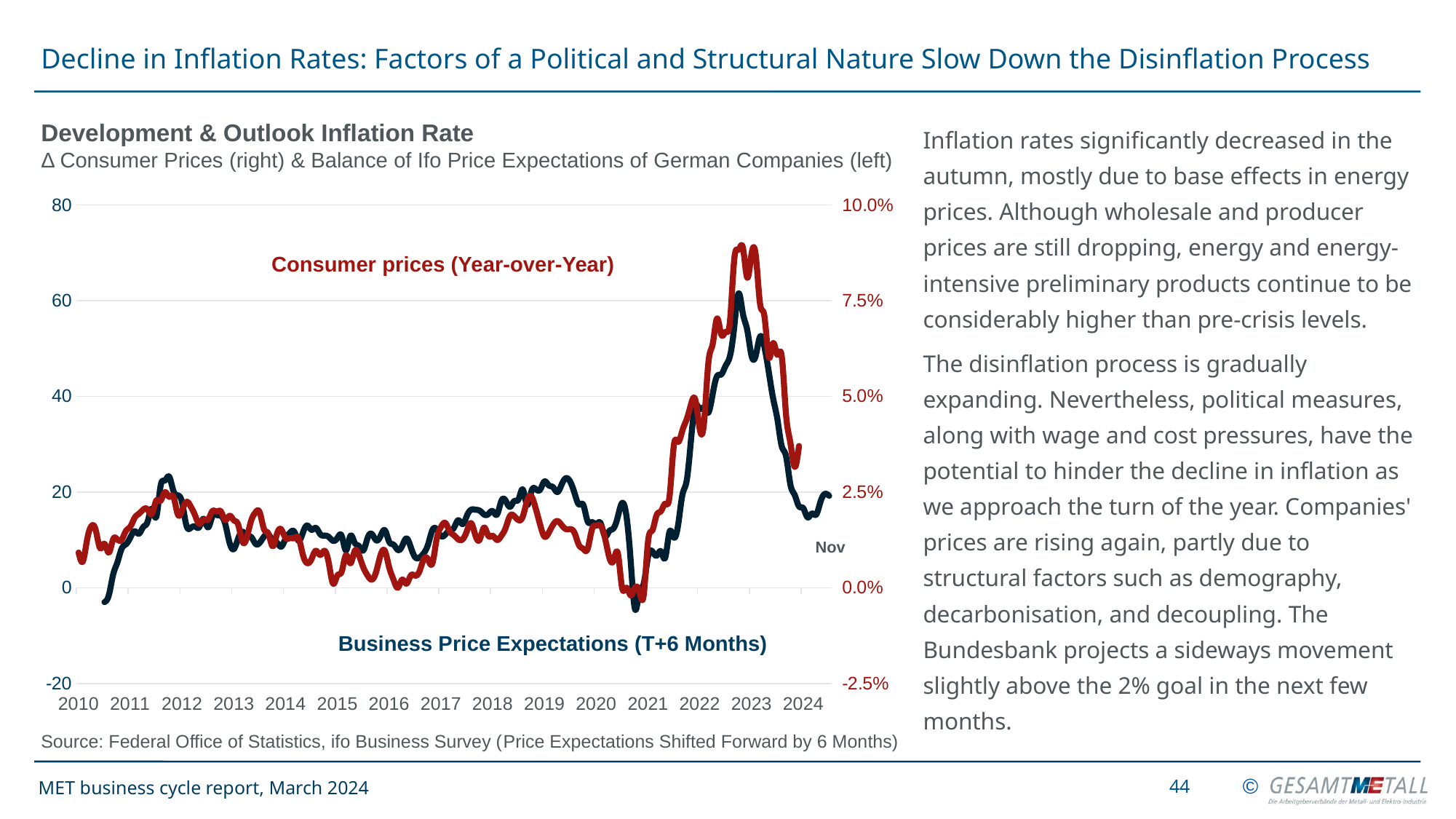
Is the value of Consumer prices (Year-over-Year) during 2016 greater or less than 2.5%? less Which series is plotted against the right-hand axis? Consumer prices (Year-over-Year) How many year labels are shown on the x axis? 15 Is the peak value of Consumer prices (Year-over-Year) in 2022 greater or less than 7.5%? greater What kind of chart is shown on the slide? line chart How many data series are plotted in the chart? 2 Is the lowest value of Business Price Expectations (T+6 Months) around 2020 greater or less than 0? less Does Business Price Expectations (T+6 Months) rise or fall from 2021 to 2022? rise What is the title of the chart? Development & Outlook Inflation Rate Does Consumer prices (Year-over-Year) rise or fall from its 2022 peak to 2024? fall